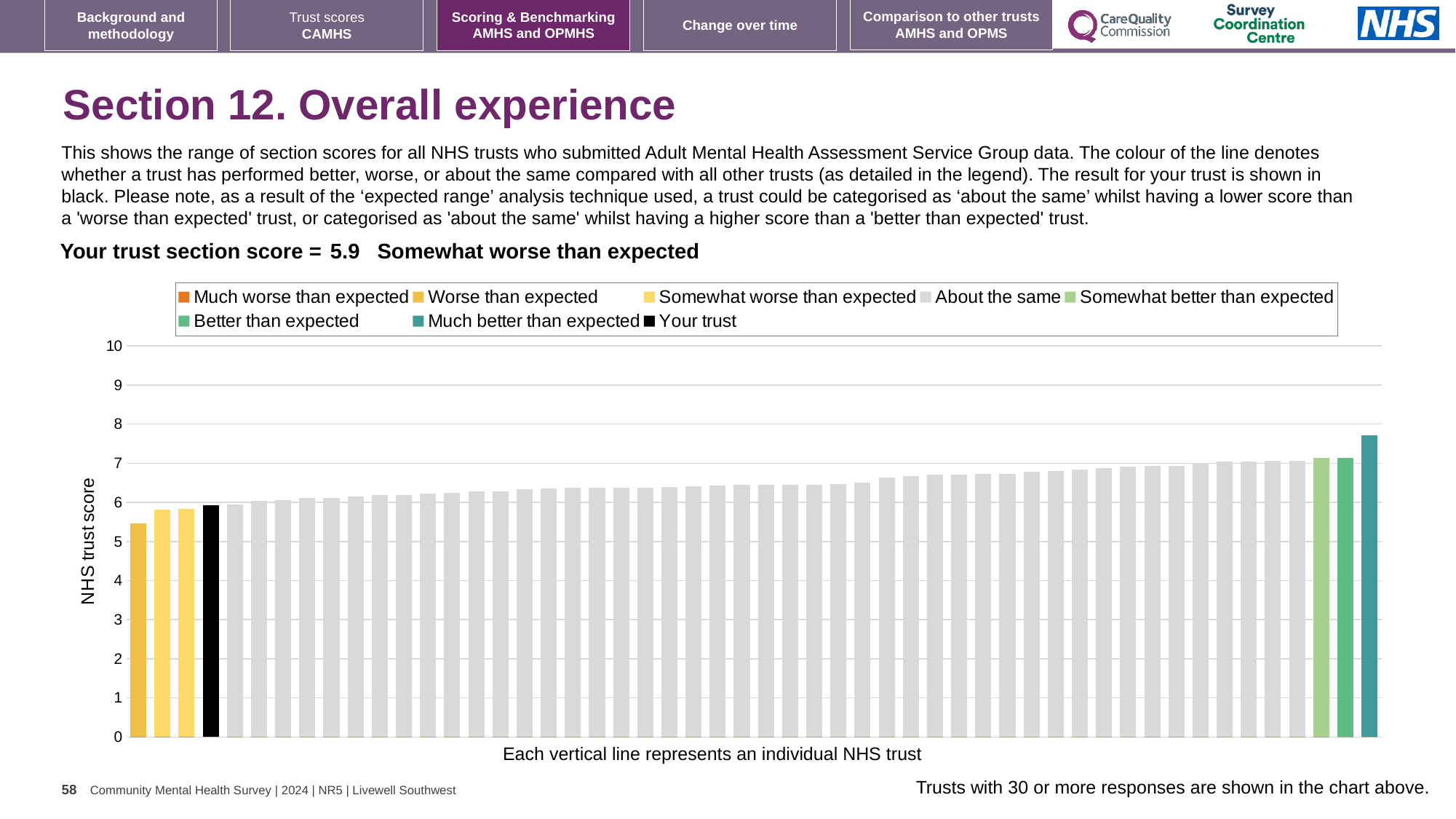
How many bars are coloured teal for 'Much better than expected'? 1 What is the section score for your trust, as printed on the slide? 5.9 Is the value of the leftmost bar greater or less than 6? less What is the label on the vertical axis of the chart? NHS trust score Is the value of the black 'Your trust' bar greater or less than 5? greater What colour is the bar representing your trust? black Is the value of the tallest bar (the rightmost, teal bar) greater or less than 7? greater Which bar is larger: the leftmost bar or the rightmost bar? the rightmost bar How many bars are coloured orange for 'Much worse than expected'? 0 How many entries does the chart legend list? 8 What kind of chart is shown on the slide? bar chart Do the bar values rise or fall moving from left to right along the x axis? rise